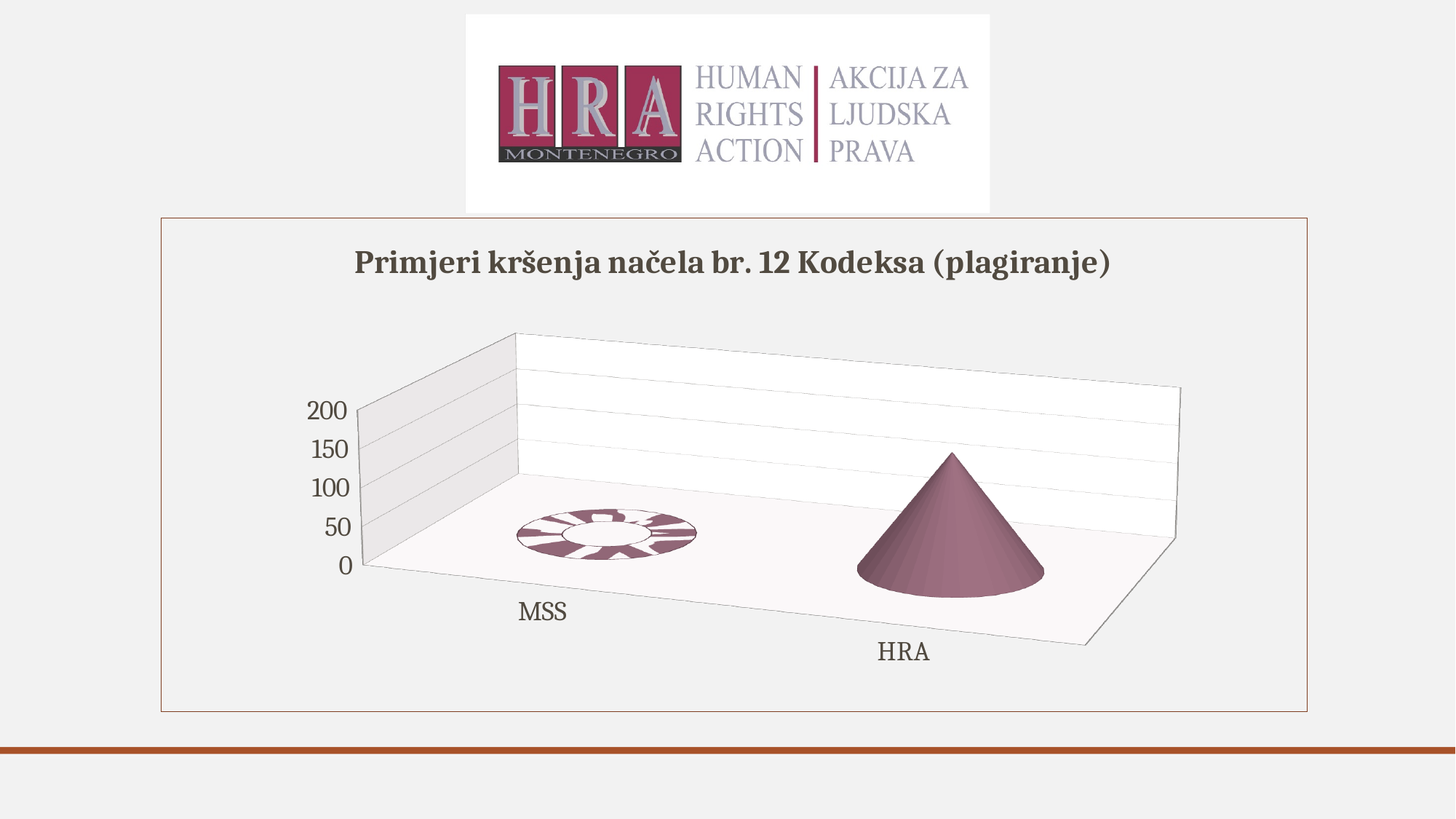
What kind of chart is shown on the slide? bar chart Is the value for MSS greater or less than 50? less Which is larger, the value for MSS or the value for HRA? HRA What is the highest value shown on the vertical axis? 200 What is the title of the chart? Primjeri kršenja načela br. 12 Kodeksa (plagiranje) Which category has the highest value? HRA How many categories are shown on the chart's x axis? 2 Do the values rise or fall going from MSS to HRA along the x axis? rise Is the value for HRA greater or less than 50? greater Which category has the lowest value? MSS